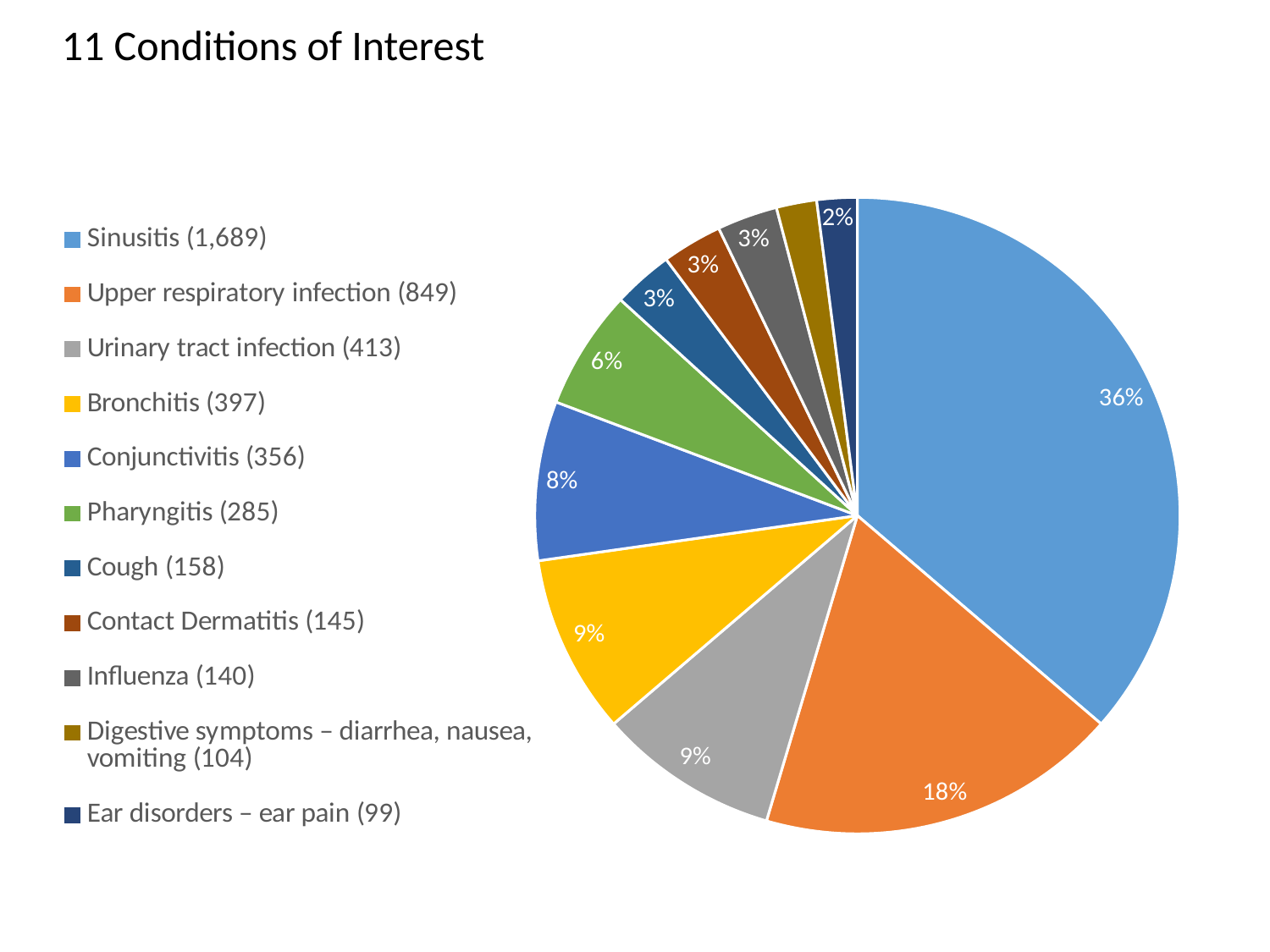
Which condition has the largest slice of the pie? Sinusitis What is the count shown in the legend for Influenza? 140 What is the difference between the Sinusitis count (1,689) and the Upper respiratory infection count (849)? 840 What share of the pie does Pharyngitis represent? 6% What share of the pie does Conjunctivitis represent? 8% Which condition has the smallest count in the legend? Ear disorders – ear pain What share of the pie does Sinusitis represent? 36% What is the count shown in the legend for Bronchitis? 397 What kind of chart is shown on the slide? pie chart Which has a larger slice, Conjunctivitis or Pharyngitis? Conjunctivitis How many conditions (slices) does the pie chart show? 11